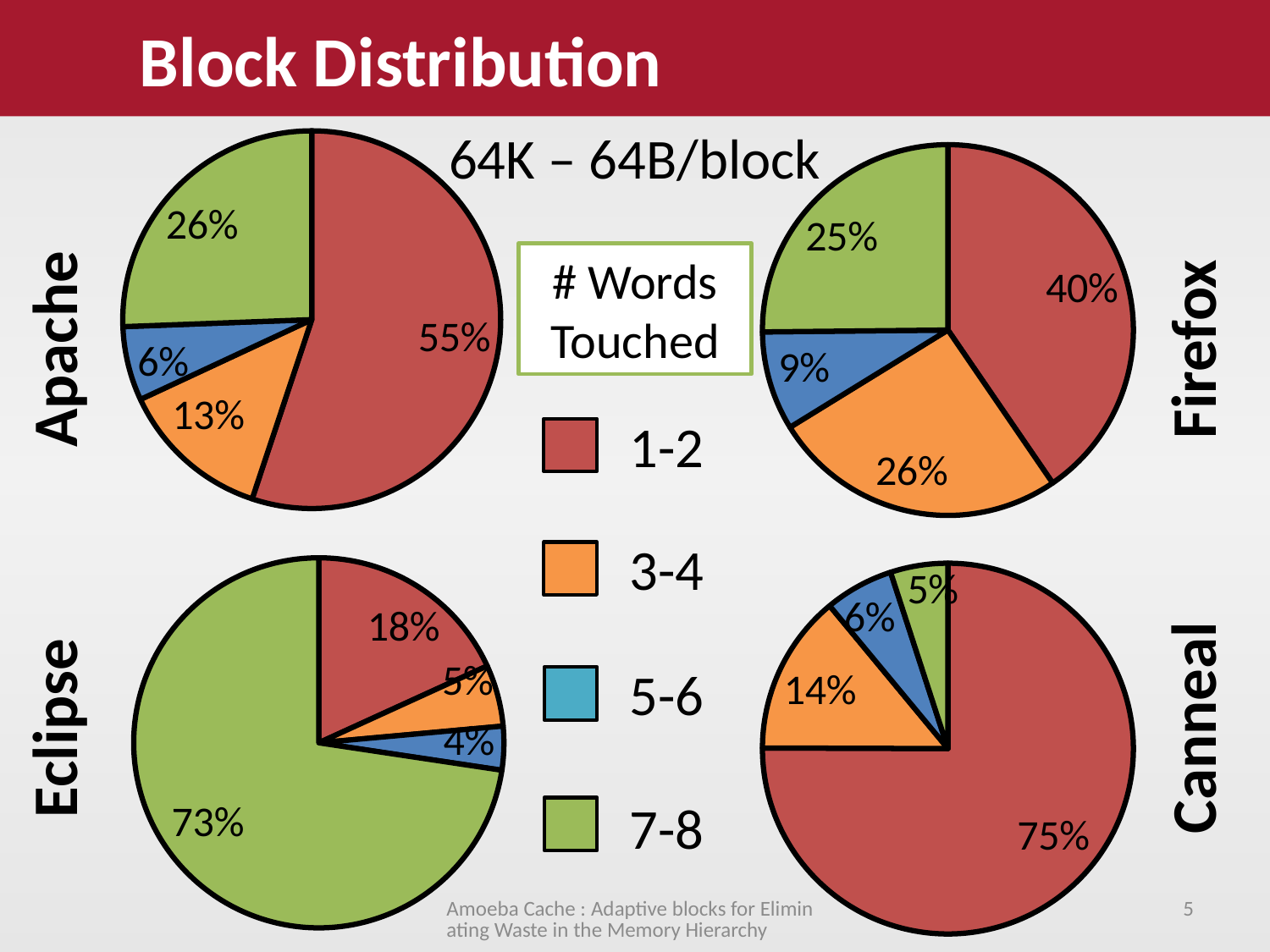
What does the legend on the slide say the slices represent? # Words Touched In the Firefox pie chart, which category has the largest slice? 1-2 What kind of chart is used for each of the four benchmarks on the slide? Pie chart In the Eclipse pie chart, what share of blocks have 7-8 words touched? 73% In the Apache pie chart, what is the difference between the 1-2 slice and the 7-8 slice? 29% In the Apache pie chart, what share of blocks have 1-2 words touched? 55% In the Firefox pie chart, which is larger: the 3-4 slice or the 7-8 slice? 3-4 In the Firefox pie chart, what share of blocks have 3-4 words touched? 26% In the Eclipse pie chart, which category has the largest slice? 7-8 How many categories does the legend list? 4 In the Canneal pie chart, which category has the smallest slice? 7-8